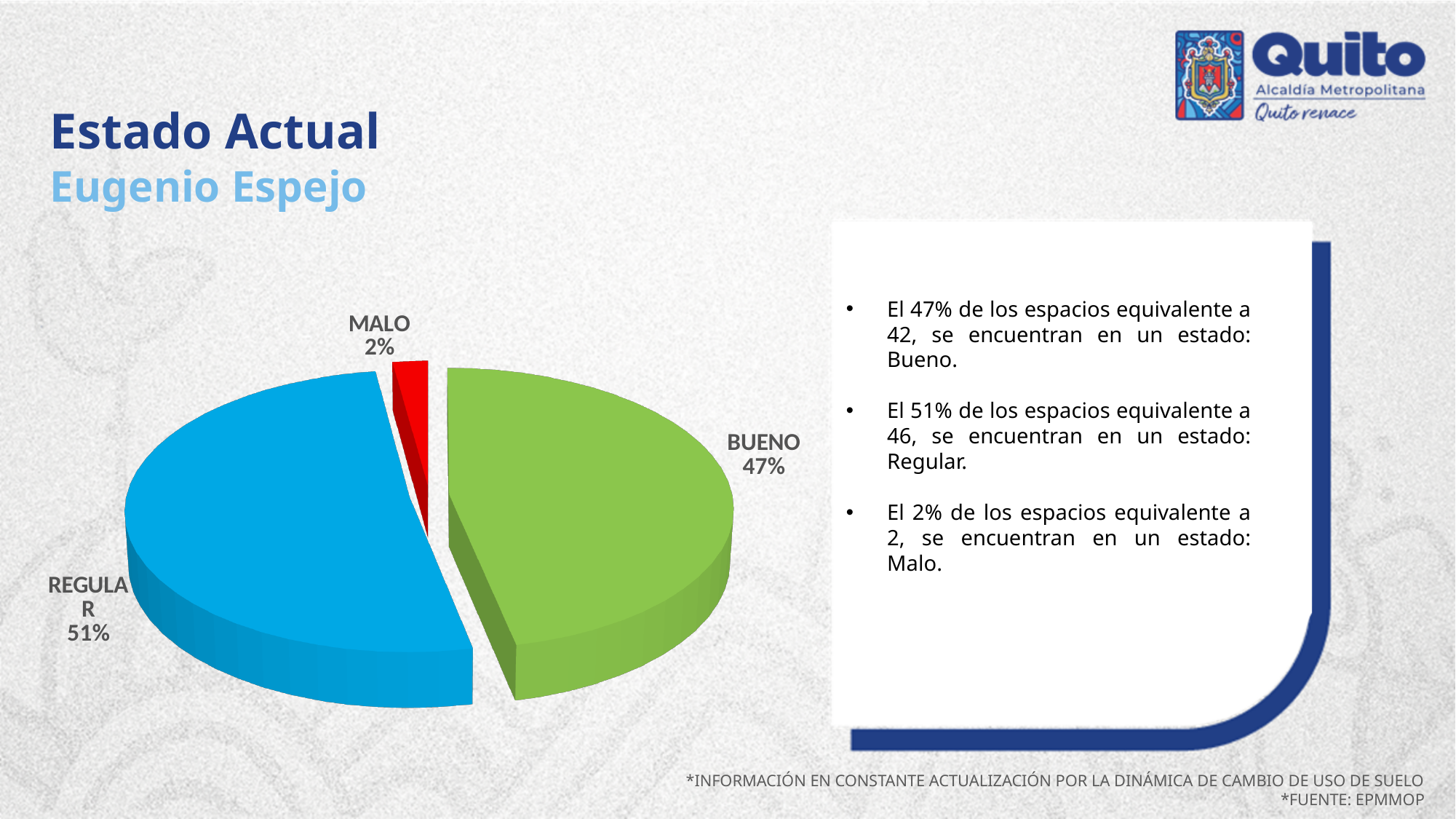
What share of the pie does the REGULAR slice represent? 51% What share of the pie does the MALO slice represent? 2% What share of the pie does the BUENO slice represent? 47% What colour is the MALO slice of the pie? Red What is the difference in percentage points between the REGULAR and BUENO slices? 4% What colour is the REGULAR slice of the pie? Blue What kind of chart is shown on the slide? Pie chart How many categories are shown in the pie chart? 3 Which category has the largest slice of the pie? REGULAR Which slice is larger, BUENO or MALO? BUENO What is the difference in percentage points between the BUENO and MALO slices? 45% Which category has the smallest slice of the pie? MALO